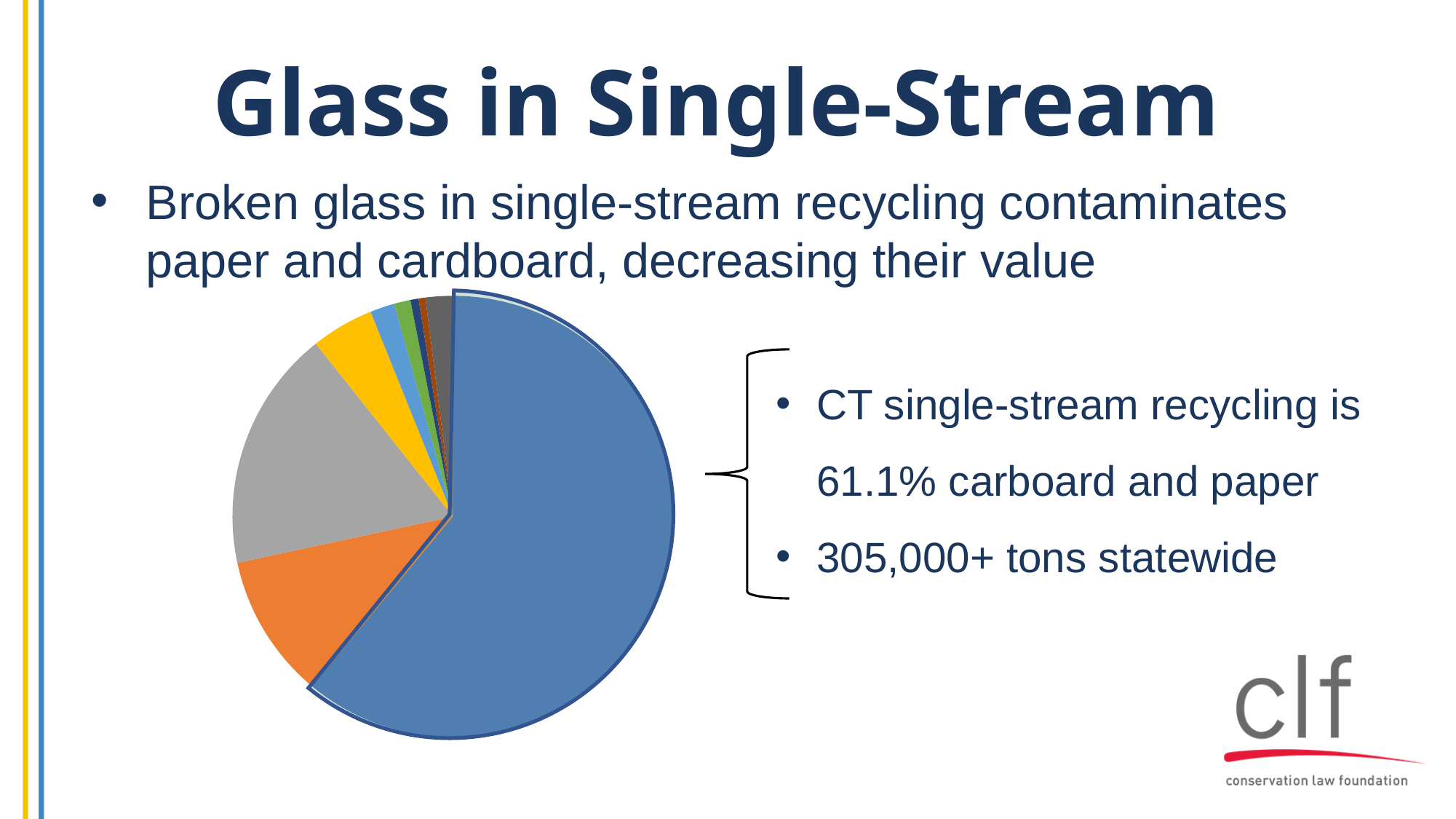
What kind of chart is shown on the slide? pie chart What share of CT single-stream recycling is cardboard and paper, as shown by the large blue slice? 61.1% Which colour slice is the largest in the pie chart? blue Which is larger in the pie chart, the orange slice or the yellow slice? orange Does the pie chart have a legend? No Which is larger in the pie chart, the gray slice or the orange slice? gray What does the bracket next to the pie chart say the large blue slice represents? cardboard and paper Is the largest slice of the pie chart greater or less than 50% of the whole? greater